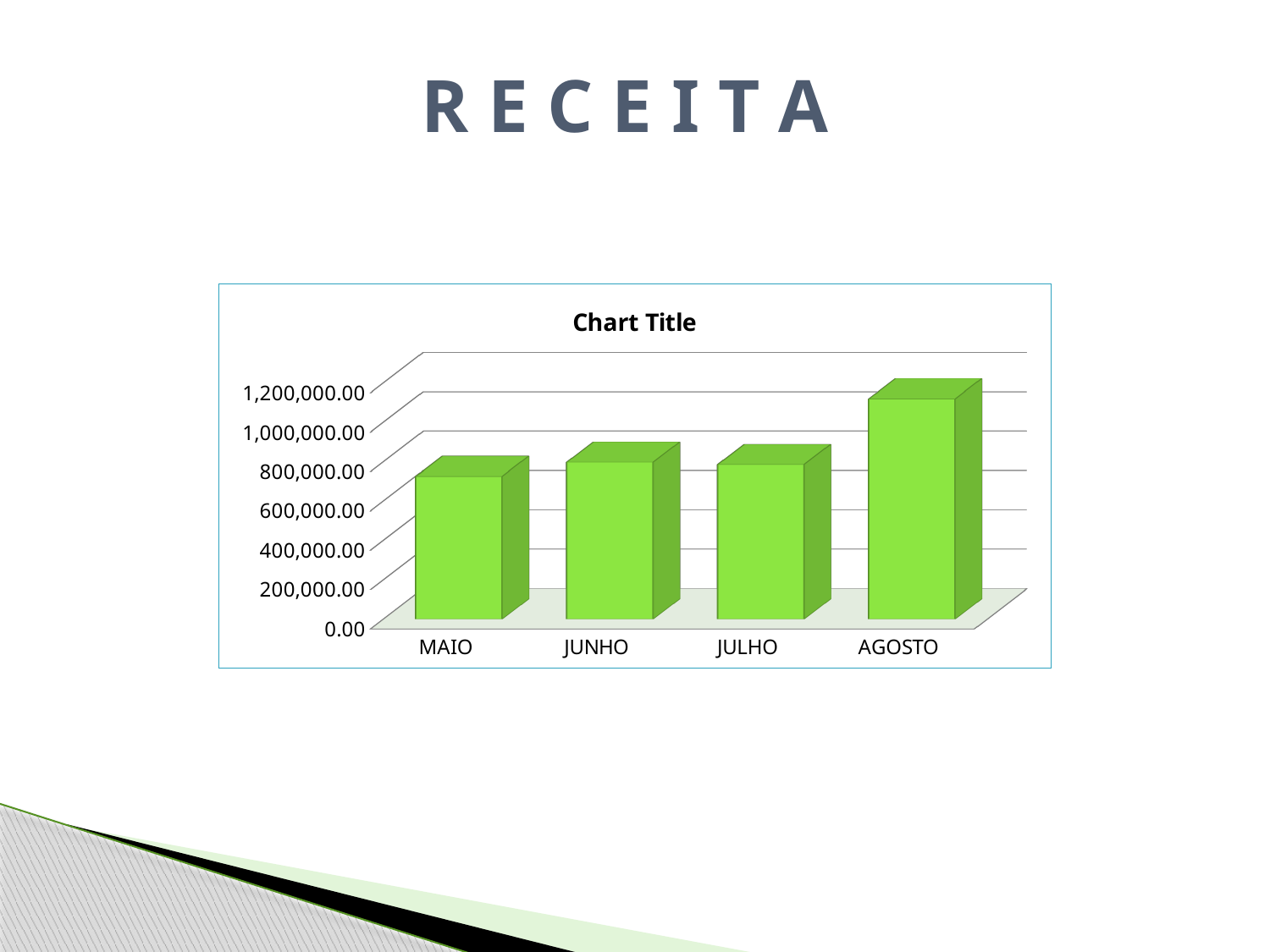
How many categories are shown on the x axis of the chart? 4 Is the value for AGOSTO greater or less than 1,200,000.00? less What colour are the bars in the chart? green Is the value for MAIO greater or less than 600,000.00? greater Is the value for JUNHO greater or less than 600,000.00? greater Which is larger, the value for AGOSTO or the value for MAIO? AGOSTO Which is larger, the value for JUNHO or the value for MAIO? JUNHO What is the title shown above the chart? Chart Title What kind of chart is shown on the slide? bar chart Which month has the highest value in the chart? AGOSTO